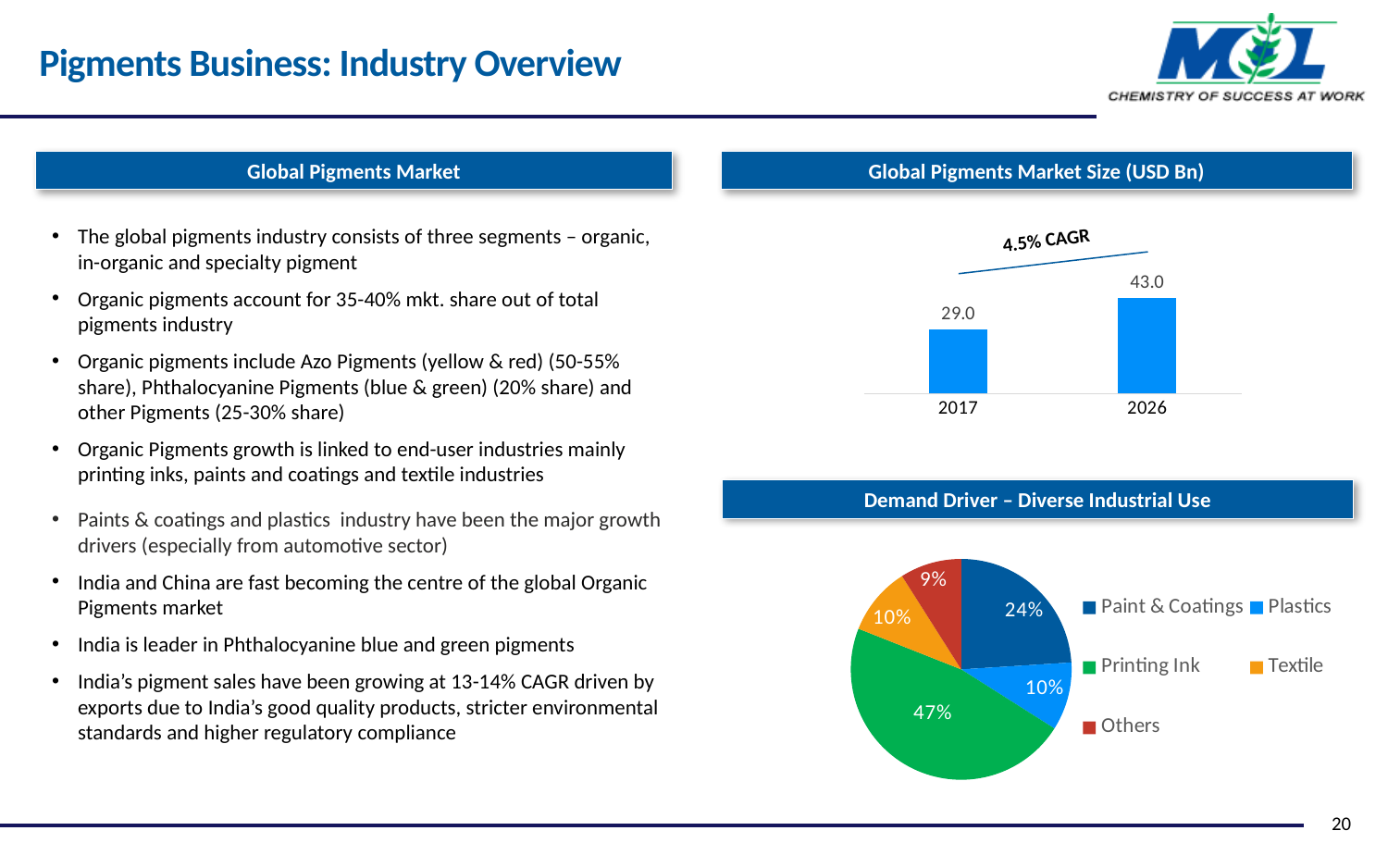
In the Global Pigments Market Size (USD Bn) chart, what is the value for 2026? 43.0 In the Global Pigments Market Size (USD Bn) chart, what CAGR is shown? 4.5% CAGR In the Demand Driver – Diverse Industrial Use chart, what share does Printing Ink have? 47% How many categories does the legend of the Demand Driver – Diverse Industrial Use chart list? 5 In the Global Pigments Market Size (USD Bn) chart, do the values rise or fall from 2017 to 2026? rise In the Global Pigments Market Size (USD Bn) chart, what is the value for 2017? 29.0 In the Demand Driver – Diverse Industrial Use chart, what share does Paint & Coatings have? 24% In the Demand Driver – Diverse Industrial Use chart, which category has the smallest share? Others What type of chart is the Demand Driver – Diverse Industrial Use chart? pie chart In the Global Pigments Market Size (USD Bn) chart, what is the difference between the 2026 and 2017 values? 14.0 In the Demand Driver – Diverse Industrial Use chart, which category has the largest share? Printing Ink What type of chart is the Global Pigments Market Size (USD Bn) chart? bar chart